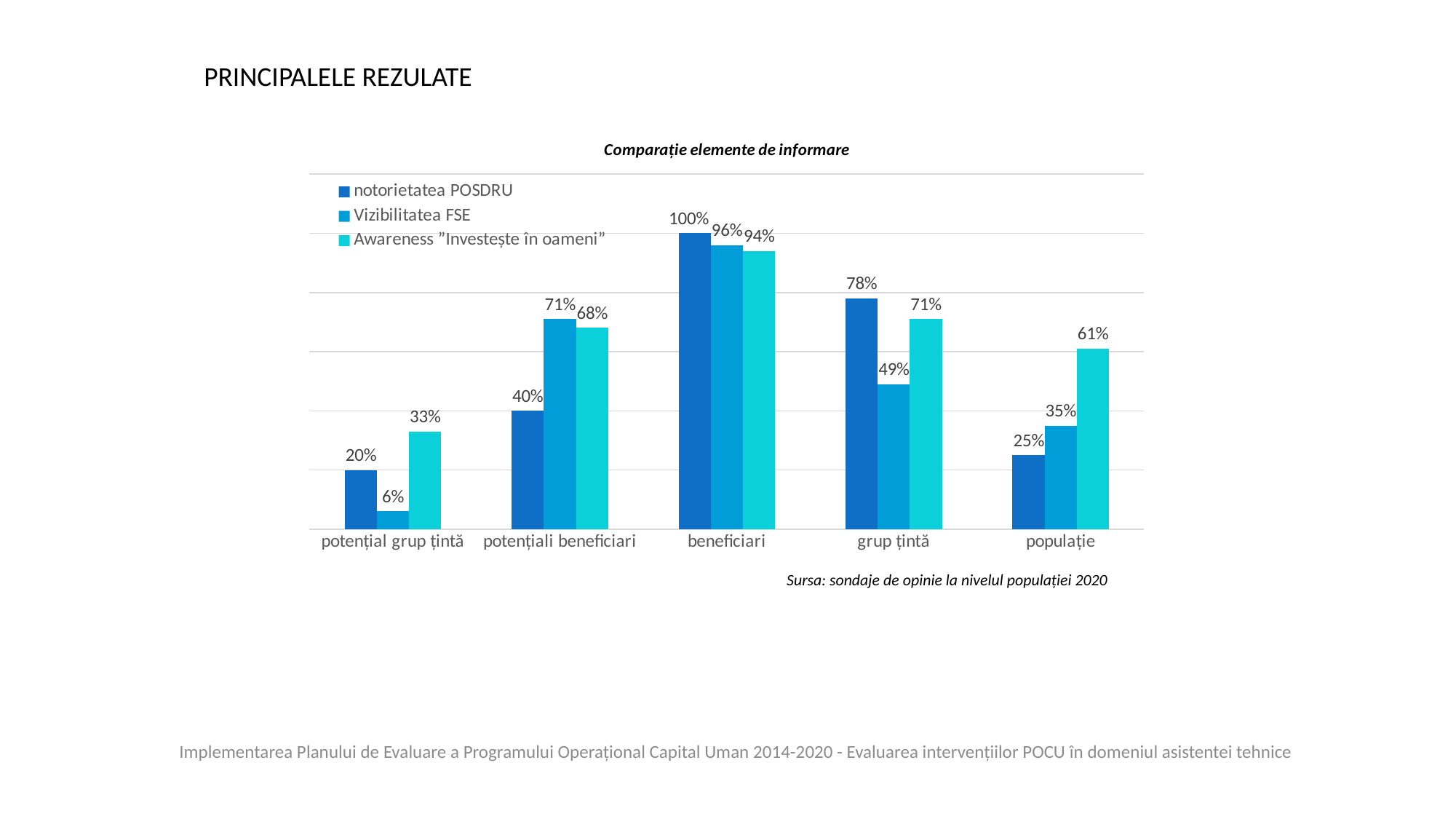
What is the difference between notorietatea POSDRU and Vizibilitatea FSE for grup țintă? 29% How many categories are shown on the x axis? 5 What is the value of Vizibilitatea FSE for potențial grup țintă? 6% What is the title of the chart? Comparație elemente de informare Which category has the lowest value for Vizibilitatea FSE? potențial grup țintă What is the value of notorietatea POSDRU for beneficiari? 100% What is the value of Awareness ”Investește în oameni” for populație? 61% What kind of chart is shown on the slide? bar chart Which is larger for populație: notorietatea POSDRU or Awareness ”Investește în oameni”? Awareness ”Investește în oameni” Which category has the highest value for notorietatea POSDRU? beneficiari How many series does the legend list? 3 What is the value of Vizibilitatea FSE for grup țintă? 49%